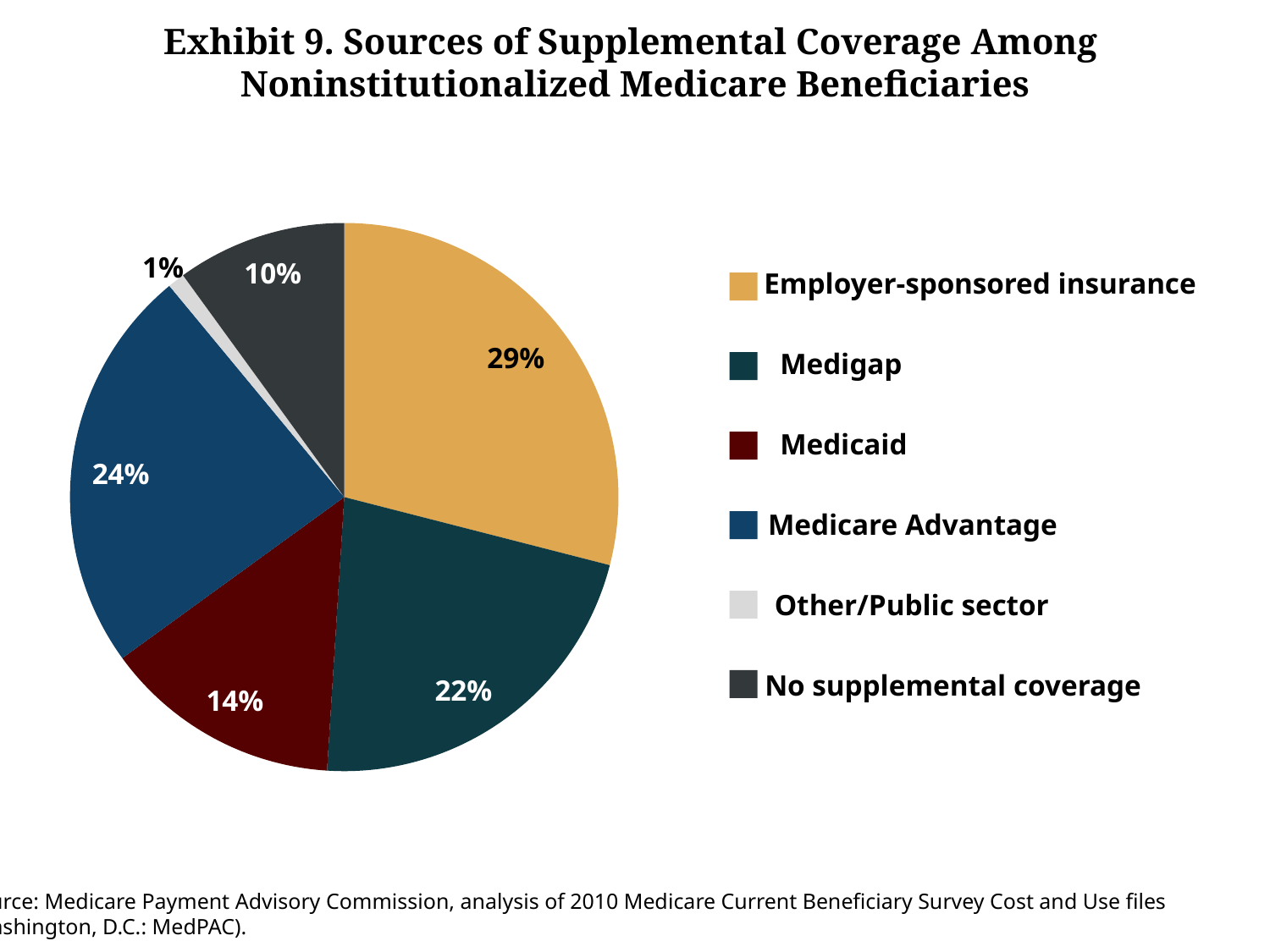
What is the difference between the Employer-sponsored insurance share and the Medicaid share? 15% What kind of chart is shown on the slide? pie chart What share of beneficiaries have No supplemental coverage? 10% What colour is the Medicare Advantage slice? blue What share of beneficiaries have Medicaid coverage? 14% What share of beneficiaries have Employer-sponsored insurance? 29% What share of beneficiaries have Medigap coverage? 22% Which is larger, the Medicare Advantage share or the Medigap share? Medicare Advantage Which source of supplemental coverage has the smallest share? Other/Public sector How many categories does the legend list? 6 What share of beneficiaries have Medicare Advantage? 24% Which source of supplemental coverage has the largest share? Employer-sponsored insurance